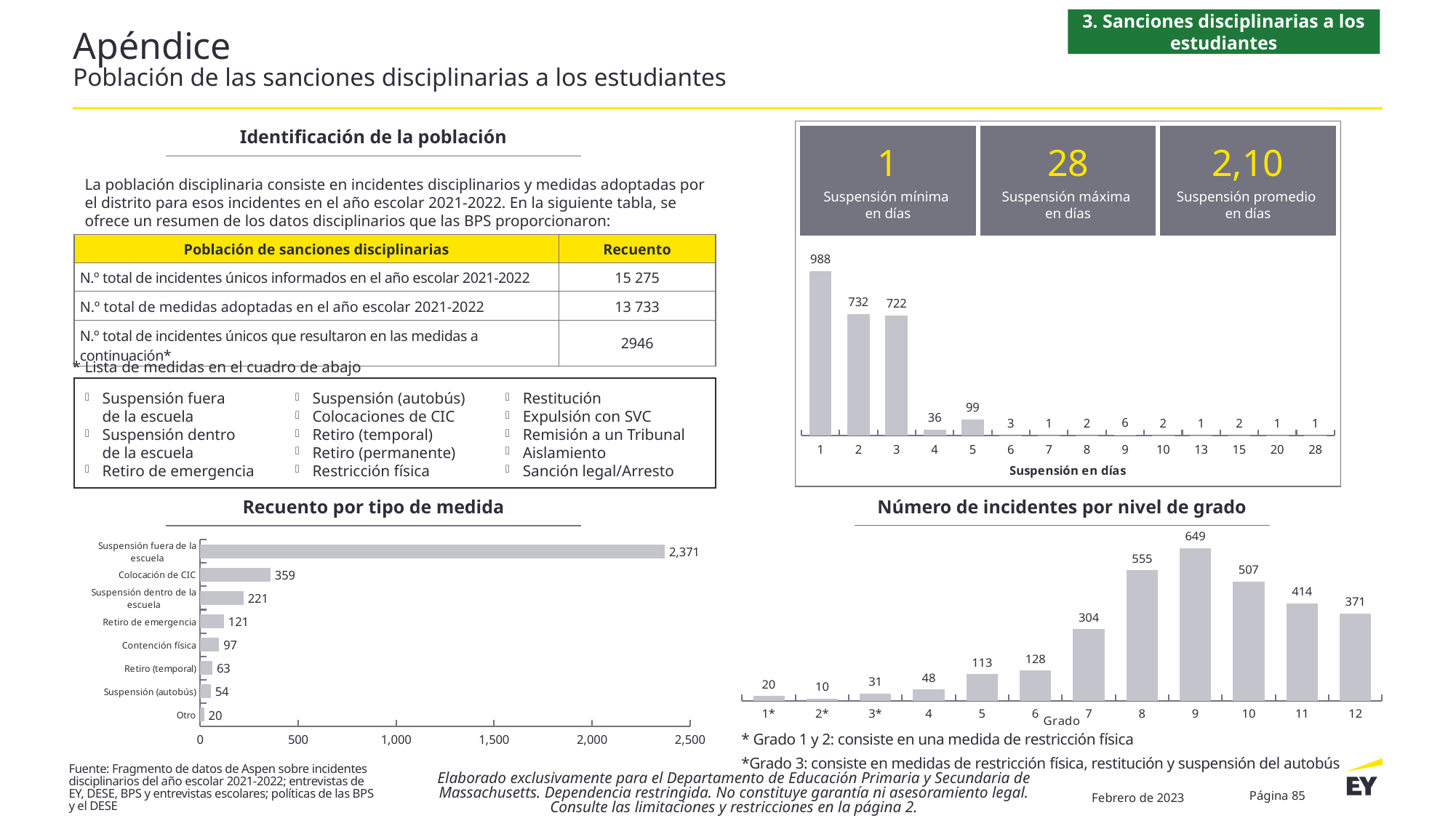
What kind of chart is 'Recuento por tipo de medida'? Bar chart In the 'Suspensión en días' chart, what is the difference between the values for 2 days and 3 days? 10 In the 'Número de incidentes por nivel de grado' chart, what is the difference between the values for grade 8 and grade 7? 251 In the 'Número de incidentes por nivel de grado' chart, how many grade categories are shown? 12 In the 'Número de incidentes por nivel de grado' chart, what is the value for grade 9? 649 In the 'Suspensión en días' chart, how many categories are shown on the x axis? 14 In the 'Recuento por tipo de medida' chart, which category has the highest value? Suspensión fuera de la escuela In the 'Suspensión en días' chart, what is the value for 1 day? 988 In the 'Recuento por tipo de medida' chart, what is the value for Colocación de CIC? 359 In the 'Número de incidentes por nivel de grado' chart, which grade has the lowest value? 2* In the 'Recuento por tipo de medida' chart, which category has the lowest value? Otro In the 'Suspensión en días' chart, which is larger, the value for 4 days or the value for 5 days? 5 days